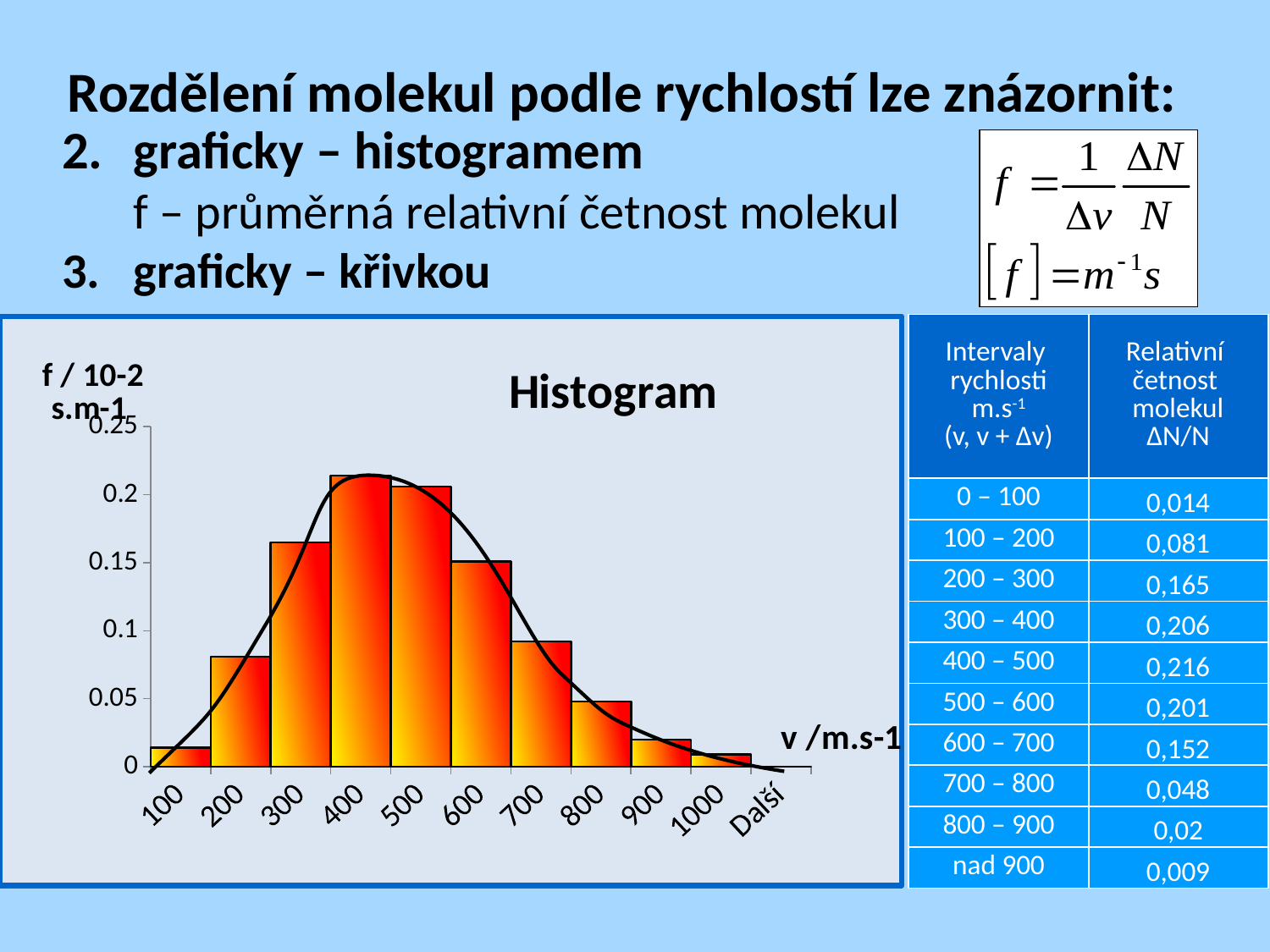
Is the value for 300 greater or less than 0.15? greater Is the value for 200 greater or less than 0.1? less Is the value for 100 greater or less than 0.05? less Which bar is taller, 200 or 700? 700 What type of chart is shown on the slide? bar chart What is the title of the chart on the slide? Histogram Do the bar values rise or fall from 500 to 1000 along the x axis? fall Which category has the lowest bar in the histogram? Další How many categories are shown on the x axis of the histogram? 11 Which bar is taller, 500 or 800? 500